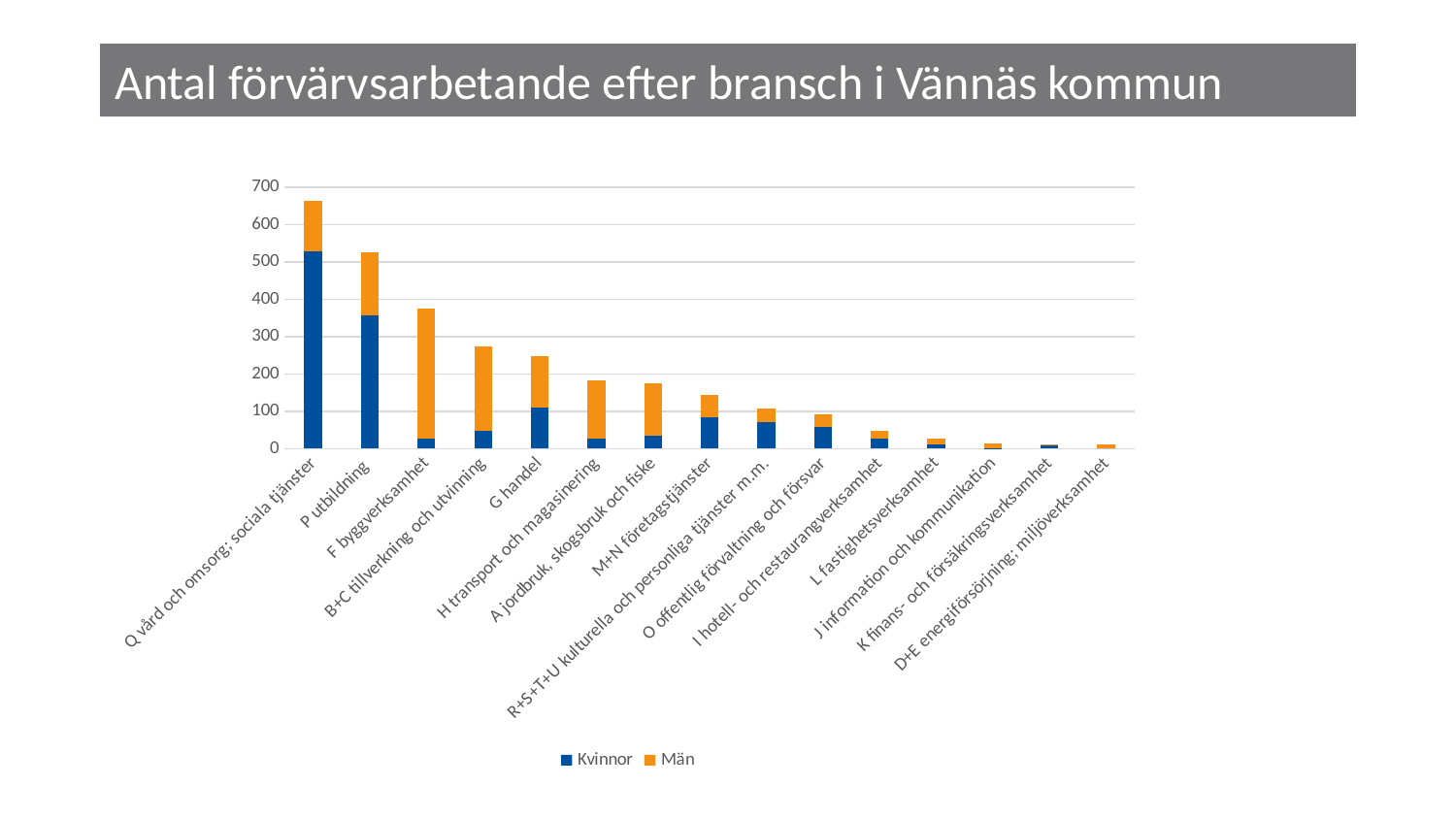
Is the total value for Q vård och omsorg; sociala tjänster greater or less than 600? greater Do the total values rise or fall moving from left to right along the x axis? Fall Which colour represents the Män series in the legend? Orange Is the total value for F byggverksamhet greater or less than 300? greater Which has a larger total, F byggverksamhet or B+C tillverkning och utvinning? F byggverksamhet Is the total value for I hotell- och restaurangverksamhet greater or less than 100? less How many industry categories are shown on the x axis? 15 What kind of chart is shown on the slide? Stacked bar chart How many series does the legend list? 2 Which industry has the highest total number of employed persons? Q vård och omsorg; sociala tjänster What is the title of the chart? Antal förvärvsarbetande efter bransch i Vännäs kommun